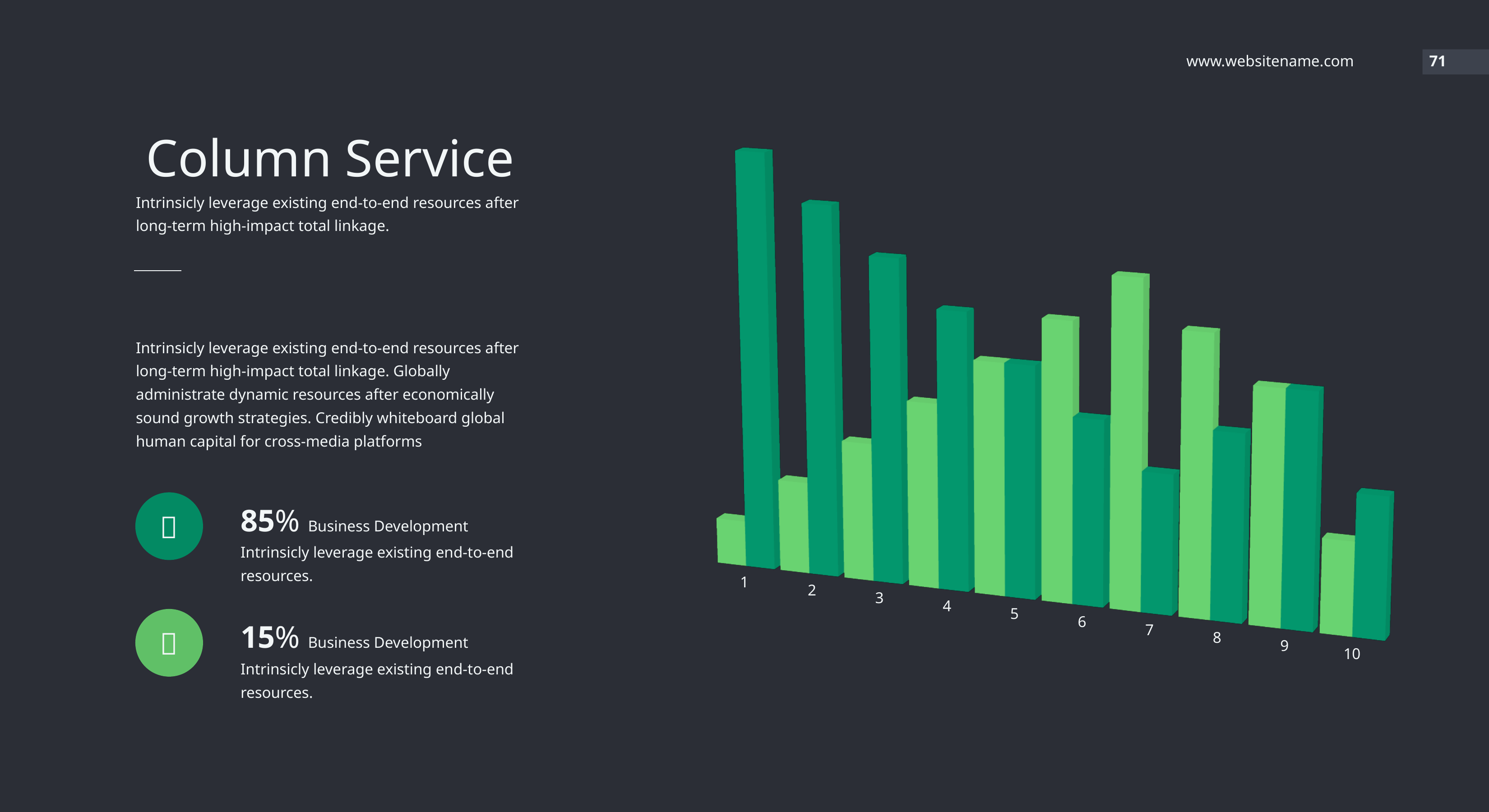
In category 1, which series has the taller bar, the dark green or the light green? dark green How many categories are shown along the x axis of the chart? 10 What kind of chart is shown on the slide? bar chart For the light green series, which category has the tallest bar? 7 What are the labels on the x axis of the chart? 1 to 10 For the dark green series, which category has the tallest bar? 1 In category 7, which series has the taller bar, the dark green or the light green? light green Do the dark green bars generally rise or fall from category 1 to category 7? fall How many data series are plotted in the chart? 2 For the dark green series, is the bar at category 1 taller or shorter than the bar at category 10? taller Do the light green bars rise or fall from category 1 to category 7? rise For the light green series, which category has the shortest bar? 1